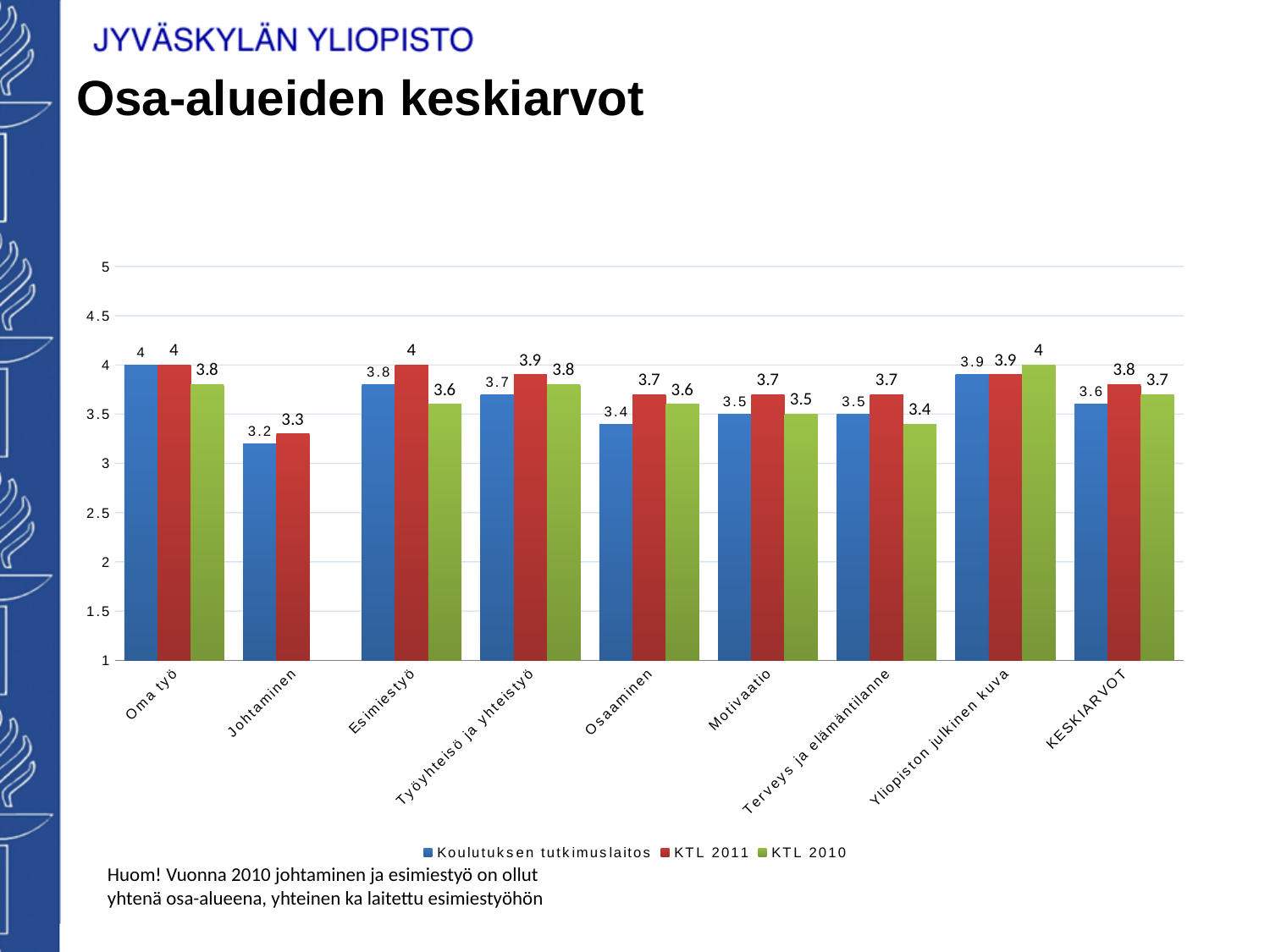
Which is larger for Esimiestyö: the KTL 2011 value or the KTL 2010 value? KTL 2011 Which category has no KTL 2010 bar? Johtaminen How many categories are shown on the x axis? 9 What is the KTL 2011 value for Esimiestyö? 4 What kind of chart is shown on the slide? Bar chart Which category has the highest KTL 2010 value? Yliopiston julkinen kuva Which category has the lowest Koulutuksen tutkimuslaitos value? Johtaminen What is the KTL 2010 value for Terveys ja elämäntilanne? 3.4 How many series does the legend list? 3 What is the Koulutuksen tutkimuslaitos value for Osaaminen? 3.4 What is the difference between the KTL 2011 and Koulutuksen tutkimuslaitos values for Osaaminen? 0.3 What is the KTL 2011 value for KESKIARVOT? 3.8